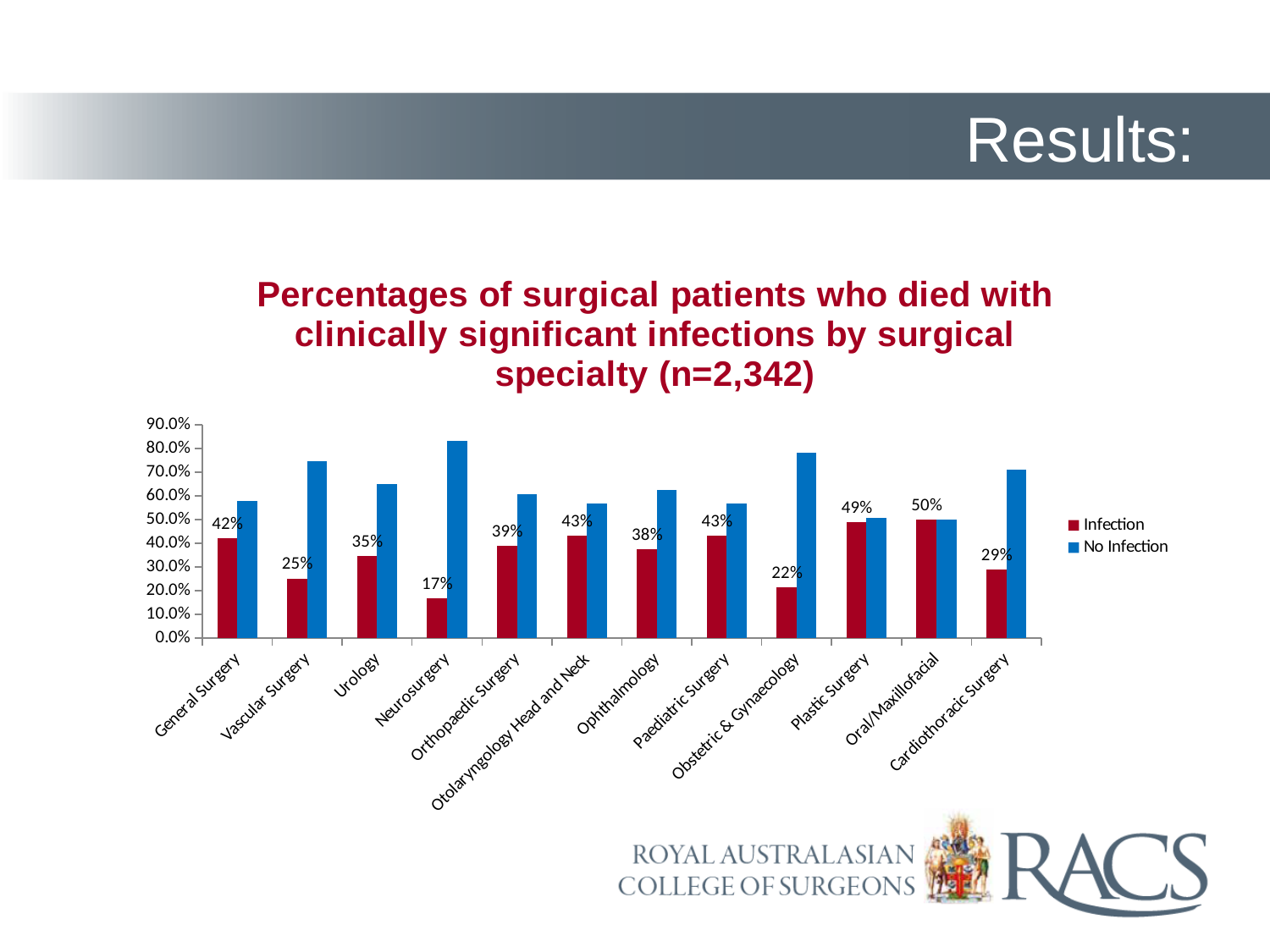
What is the Infection percentage for Neurosurgery? 17% How many series does the legend list? 2 Which surgical specialty has the lowest Infection percentage? Neurosurgery Is the No Infection value for Vascular Surgery greater or less than 70.0%? greater How many surgical specialties are shown on the x axis? 12 Is the No Infection value for Neurosurgery greater or less than 80.0%? greater Which surgical specialty has the highest Infection percentage? Oral/Maxillofacial What kind of chart is shown on the slide? Bar chart What is the difference in Infection percentage between General Surgery and Vascular Surgery? 17 percentage points What is the Infection percentage for Obstetric & Gynaecology? 22% Which has a higher Infection percentage, Plastic Surgery or Urology? Plastic Surgery What is the Infection percentage for General Surgery? 42%